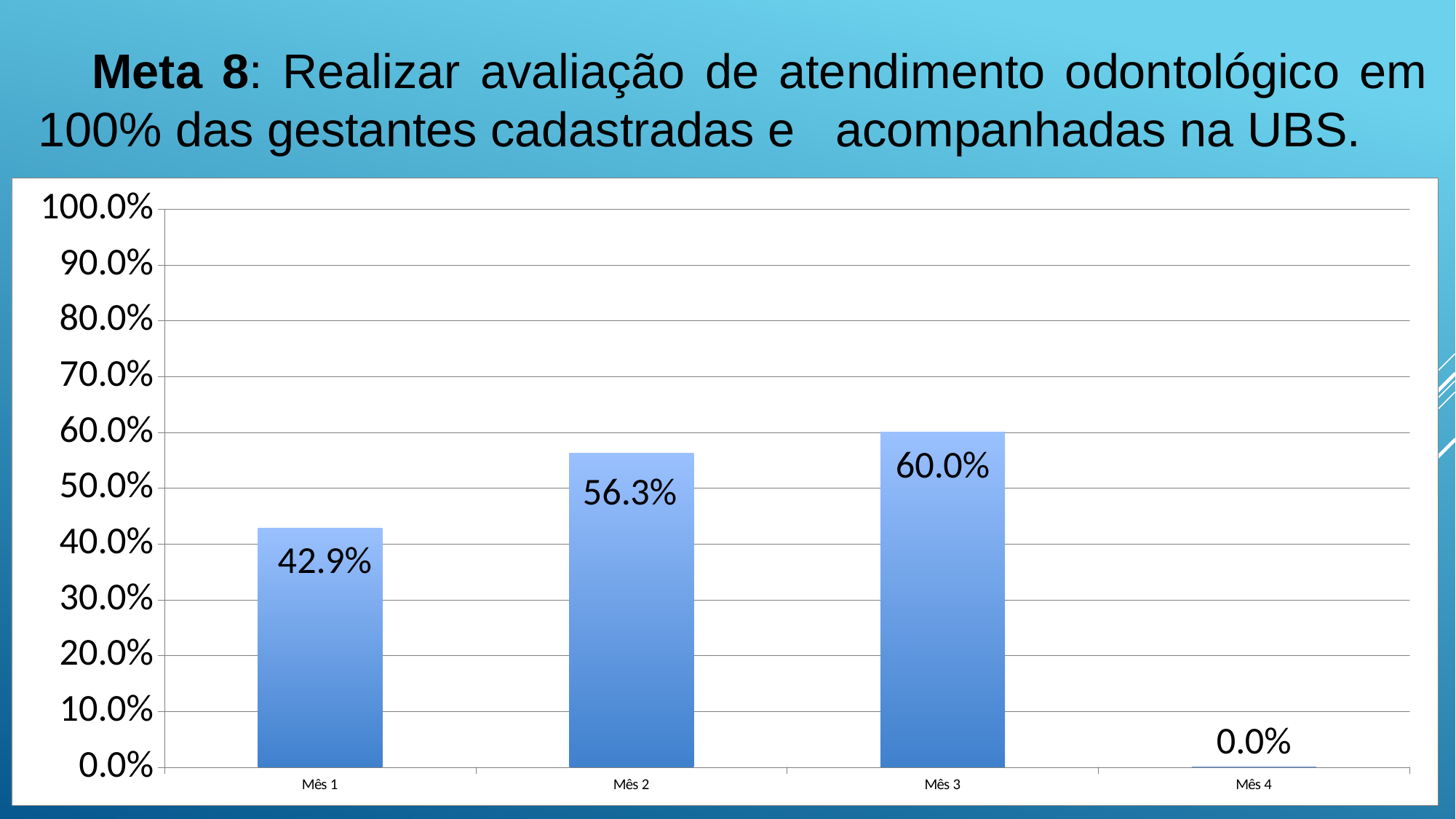
Which is larger, the value for Mês 2 or the value for Mês 1? Mês 2 What is the difference between the values for Mês 3 and Mês 1? 17.1% What kind of chart is shown on the slide? bar chart What is the value for Mês 2? 56.3% Is the value for Mês 2 greater or less than 50.0%? greater What is the value for Mês 4? 0.0% Do the values rise or fall from Mês 1 to Mês 3? rise What is the value for Mês 3? 60.0% What is the value for Mês 1? 42.9% Which month has the lowest value? Mês 4 How many months are shown on the x axis? 4 Which month has the highest value? Mês 3